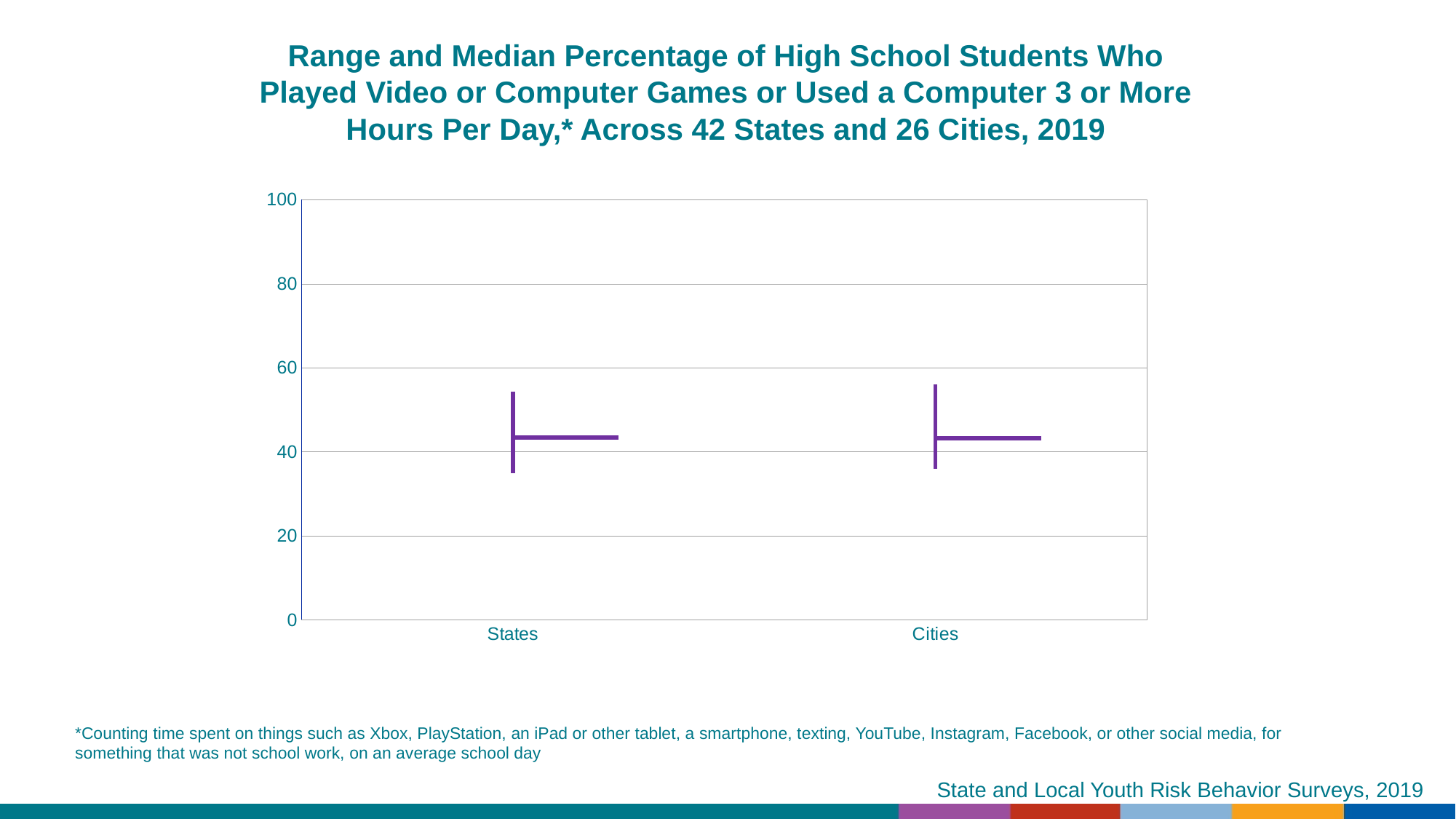
Is the median value for Cities greater or less than 60? less According to the chart title, how many states and how many cities are included? 42 states and 26 cities Is the bottom of the range for States greater or less than 40? less How many categories are shown on the x axis of the chart? 2 Is the bottom of the range for Cities greater or less than 20? greater What are the two categories shown on the x axis? States and Cities What is the maximum value shown on the y axis? 100